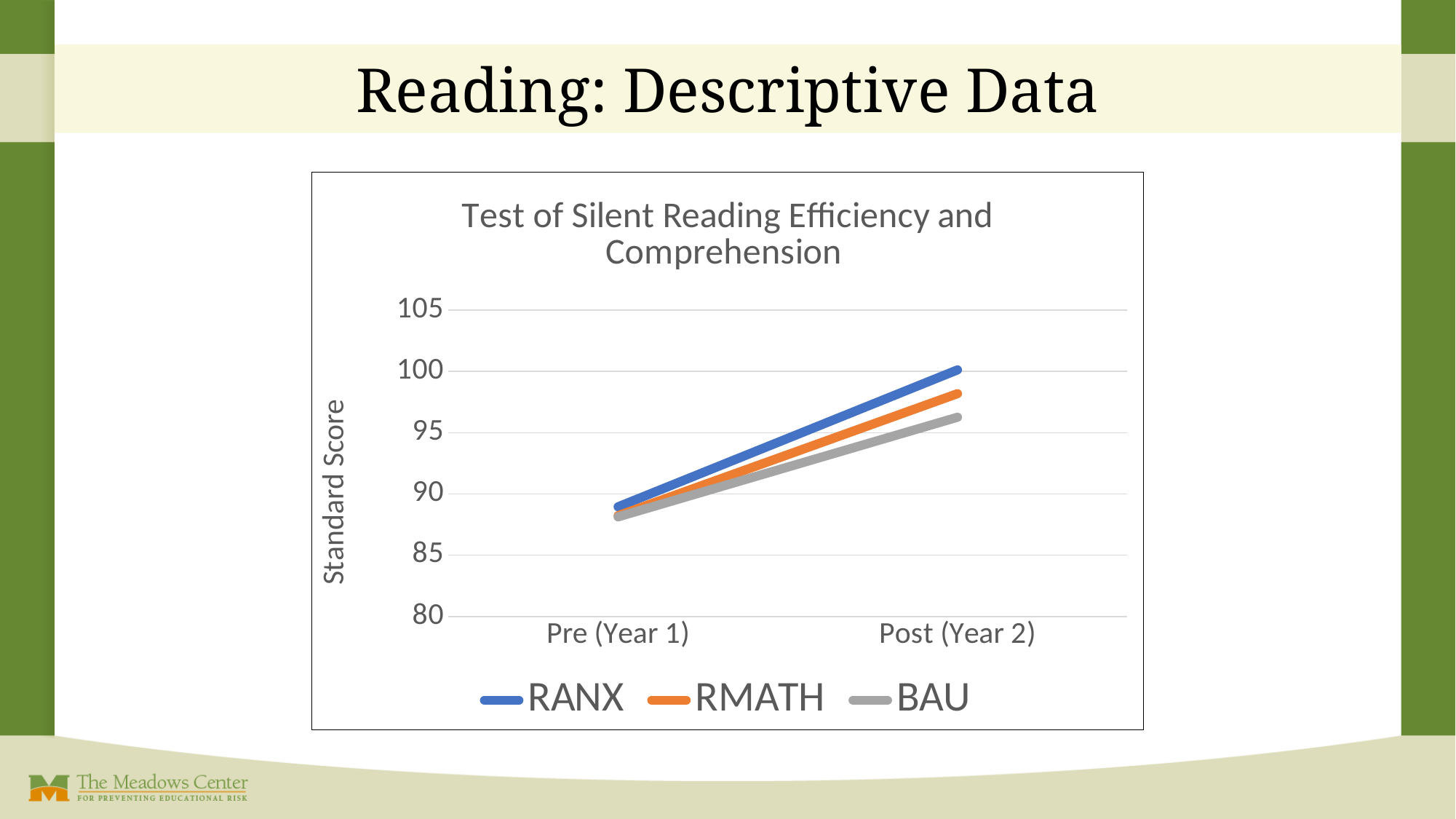
What is the label on the y axis of the chart? Standard Score Is the value for RMATH at Pre (Year 1) greater or less than 85? greater Is the value for BAU at Post (Year 2) greater or less than 100? less What kind of chart is shown on the slide? line chart At Post (Year 2), which is larger, RANX or BAU? RANX At Post (Year 2), which is larger, RMATH or BAU? RMATH How many series does the legend list? 3 Do the values for RANX rise or fall from Pre (Year 1) to Post (Year 2)? rise Which series has the lowest value at Post (Year 2)? BAU How many time points are plotted on the x axis? 2 Is the value for RANX at Post (Year 2) greater or less than 95? greater Which series has the highest value at Post (Year 2)? RANX